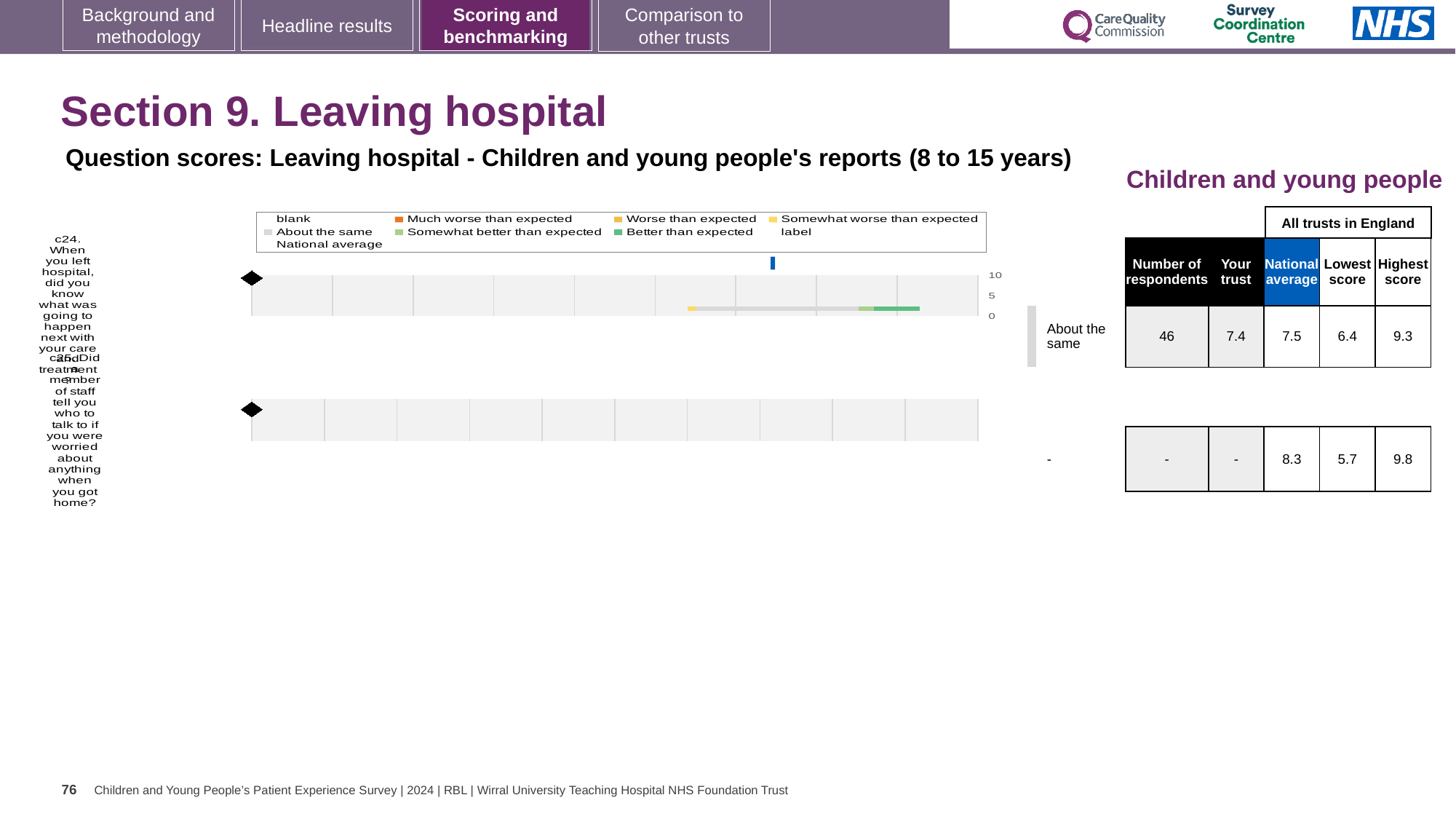
Which is larger for question c24: the trust's score or the national average? national average How many questions (categories) are plotted on the chart? 2 What benchmarking category is shown for question c24? About the same What is the national average score for question c24? 7.5 What is the difference between the highest and lowest scores for question c24? 2.9 How many respondents answered question c24? 46 What is the 'Your trust' score for question c24 (When you left hospital, did you know what was going to happen next with your care and treatment?)? 7.4 What is the national average score for question c25 (Did a member of staff tell you who to talk to if you were worried about anything when you got home?)? 8.3 Which question has the higher national average score, c24 or c25? c25 What is the lowest score among all trusts in England for question c24? 6.4 What is the highest score among all trusts in England for question c25? 9.8 What kind of chart is shown on the slide for the Leaving hospital question scores? bar chart